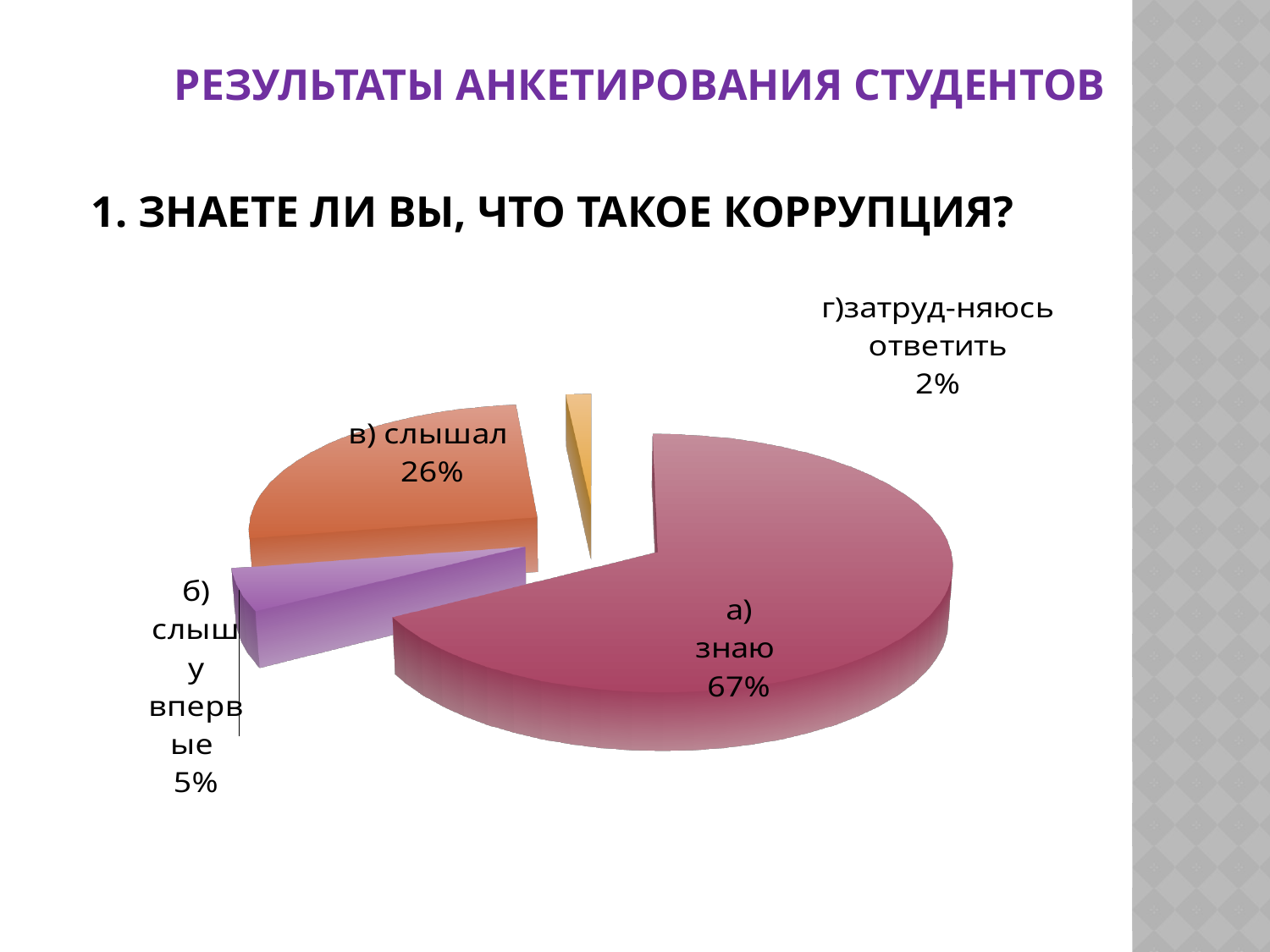
Which slice of the pie is the largest? а) знаю What kind of chart is shown on the slide? pie chart Which is larger, the slice for "в) слышал" or the slice for "б) слышу впервые"? в) слышал What share of the pie does the slice "б) слышу впервые" have? 5% How many slices does the pie chart have? 4 What is the difference in percentage points between "б) слышу впервые" and "г) затрудняюсь ответить"? 3% What is the difference in percentage points between "а) знаю" and "в) слышал"? 41% What survey question does the pie chart on the slide illustrate? 1. Знаете ли вы, что такое коррупция? What share of the pie does the slice "а) знаю" have? 67% Which slice of the pie is the smallest? г) затрудняюсь ответить What share of the pie does the slice "г) затрудняюсь ответить" have? 2%